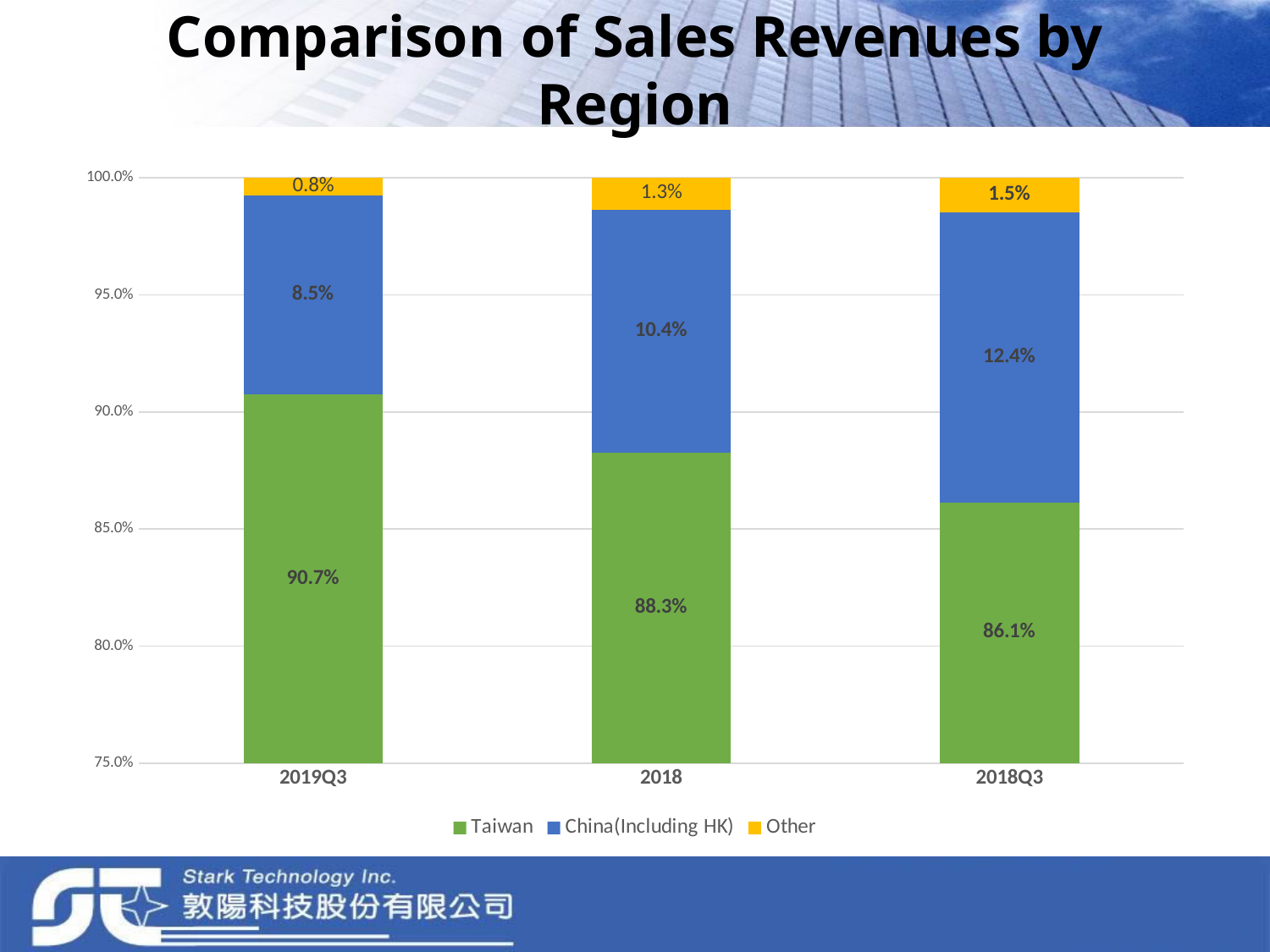
In which period is the Taiwan share highest? 2019Q3 In which period is the China(Including HK) share lowest? 2019Q3 What kind of chart is shown on the slide? Stacked bar chart What is the difference between the Taiwan share in 2019Q3 and in 2018Q3? 4.6% What is the China(Including HK) share of sales revenue in 2018Q3? 12.4% Which is larger, the Other share in 2018 or in 2018Q3? 2018Q3 Which colour represents Taiwan in the chart? Green How many series does the legend list? 3 What is the China(Including HK) share of sales revenue in 2018? 10.4% What is the Other share of sales revenue in 2018Q3? 1.5% How many periods are shown on the x axis? 3 What is the Taiwan share of sales revenue in 2019Q3? 90.7%